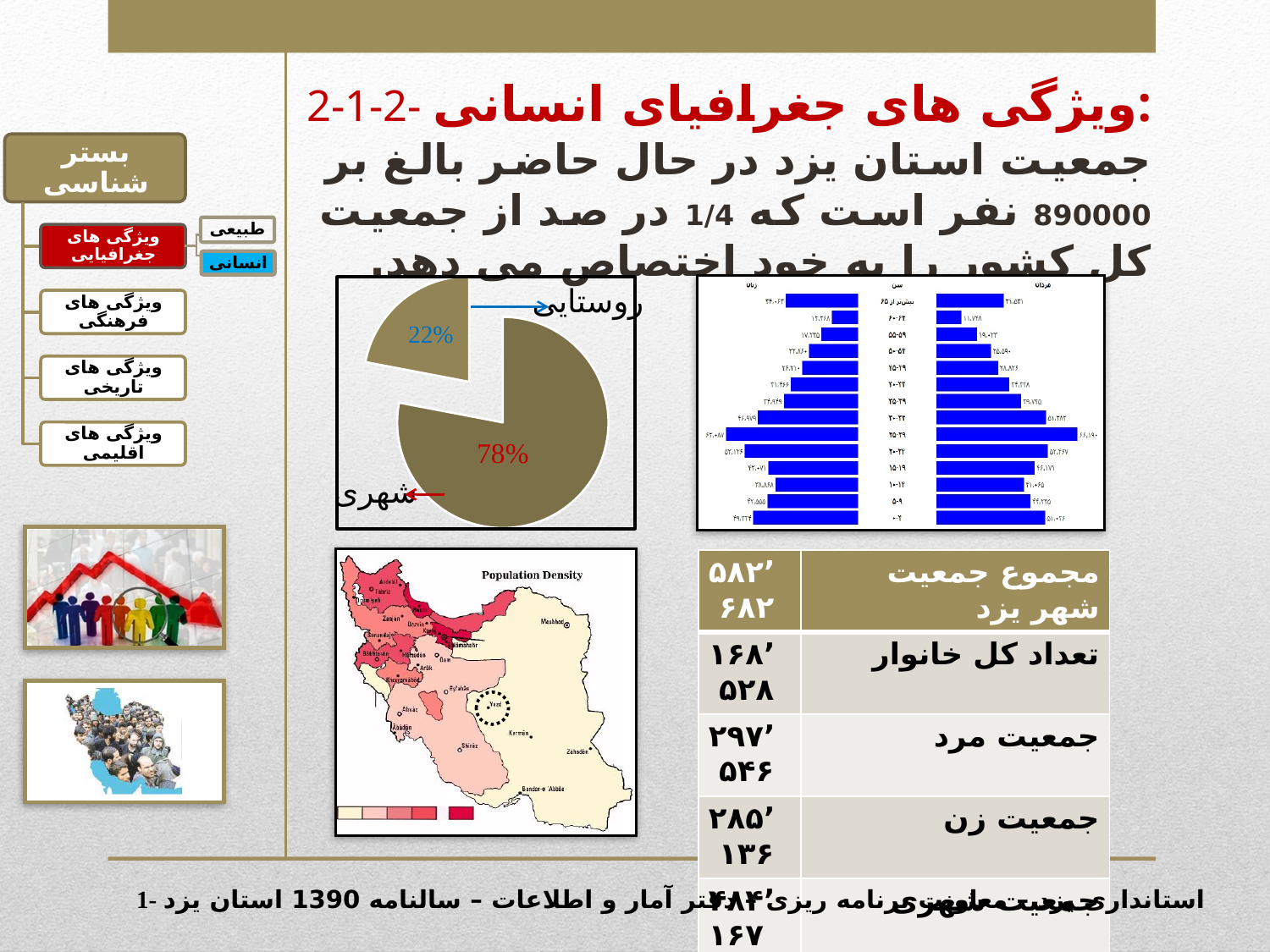
In the pie chart, is the share for شهری greater or less than 50%? greater In the pie chart, which is larger, شهری or روستایی? شهری In the pie chart, which slice is the largest? شهری In the pie chart, what is the difference in percentage points between شهری and روستایی? 56 What kind of chart is the chart showing شهری and روستایی? pie chart In the pie chart, what percentage is shown for روستایی? 22% How many slices does the pie chart have? 2 In the pie chart, which slice is pulled out (exploded) from the rest of the pie? روستایی What kind of chart is the blue chart on the right side of the slide? bar chart In the blue bar chart on the right, what are the two groups labelled at the top? مردان and زنان In the pie chart, which slice is the smallest? روستایی In the pie chart, what percentage is shown for شهری? 78%